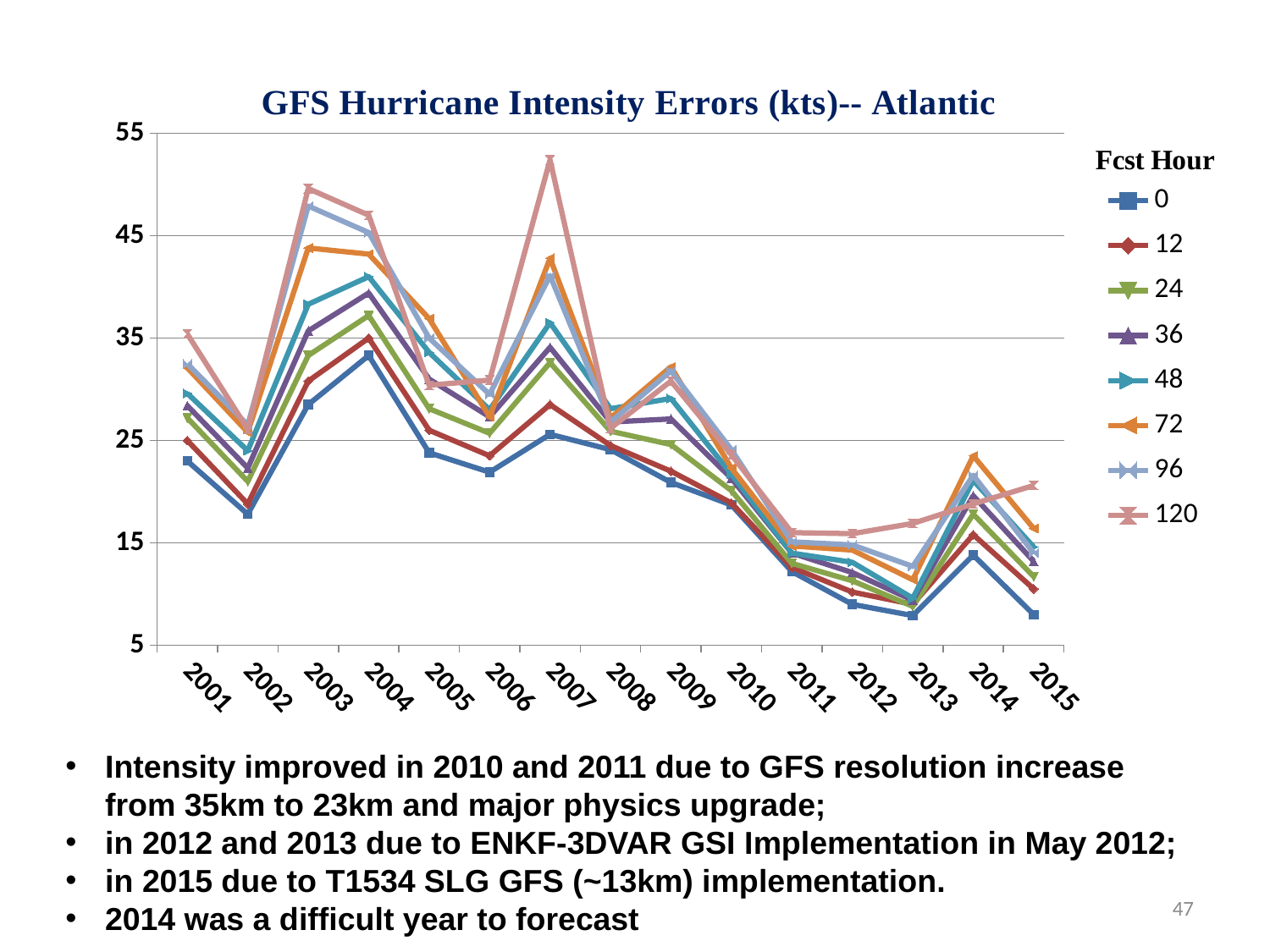
What kind of chart is shown on the slide? line chart How many series does the legend list? 8 Is the value for the 120 forecast hour series in 2007 greater or less than 45? greater Is the value for the 48 forecast hour series in 2004 greater or less than 35? greater Is the value for the 120 forecast hour series in 2015 greater or less than 15? greater For the 0 forecast hour series, is the value in 2003 or in 2011 larger? 2003 How many years are plotted along the x axis? 15 Which forecast hour series has the lowest value in 2003? 0 Which forecast hour series has the highest value in 2007? 120 What is the title of the legend? Fcst Hour What is the title of the chart? GFS Hurricane Intensity Errors (kts)-- Atlantic